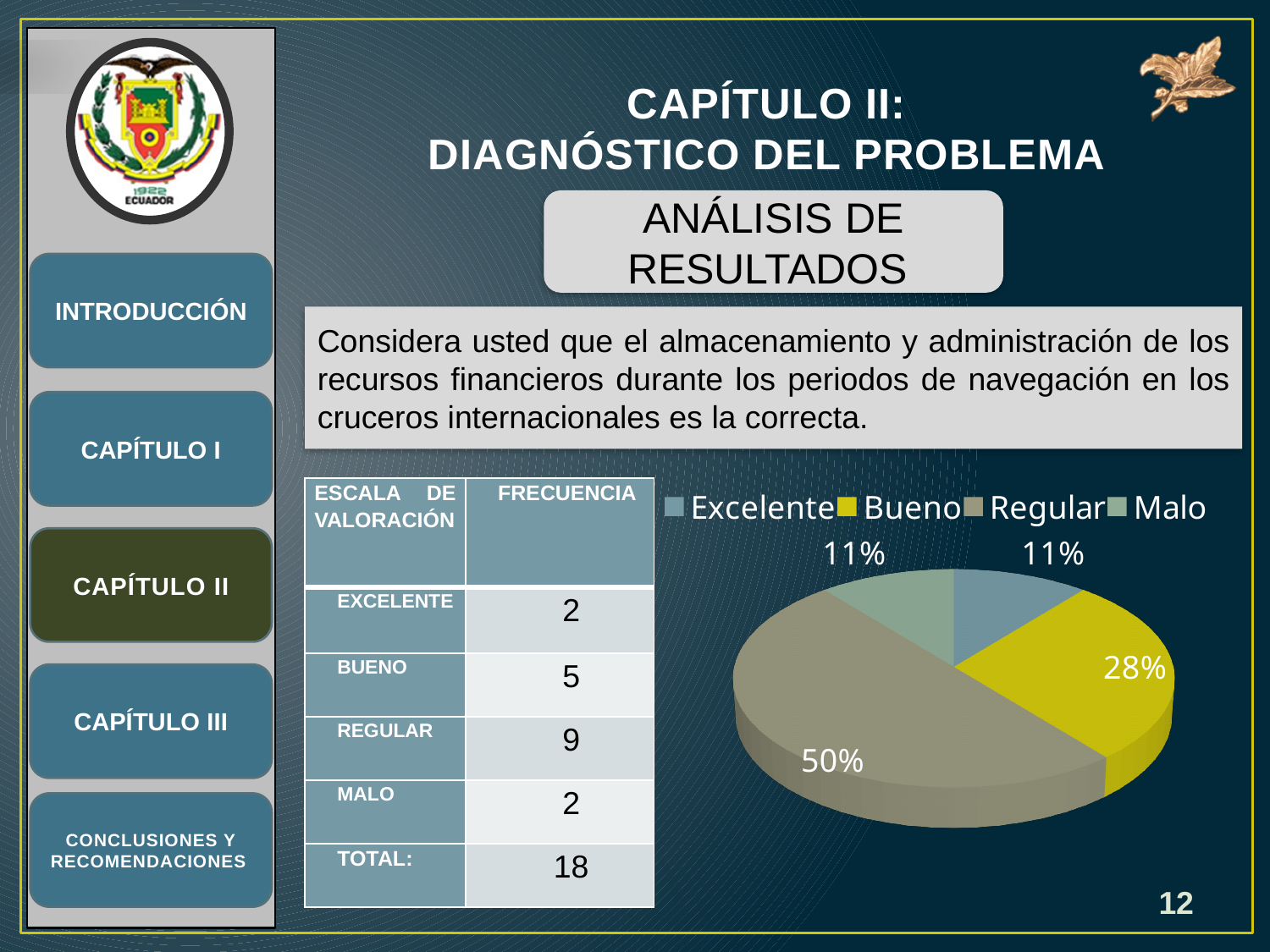
Which slice is larger, Regular or Bueno? Regular What share of the pie does Bueno represent? 28% What share of the pie does Malo represent? 11% Which category has the largest slice of the pie? Regular What kind of chart is shown on the slide? pie chart What colour is the Bueno slice in the pie chart? yellow What share of the pie does Excelente represent? 11% How many entries does the legend list? 4 Which slice is larger, Bueno or Malo? Bueno How many slices does the pie chart have? 4 What is the difference in percentage points between the Regular slice and the Bueno slice? 22%